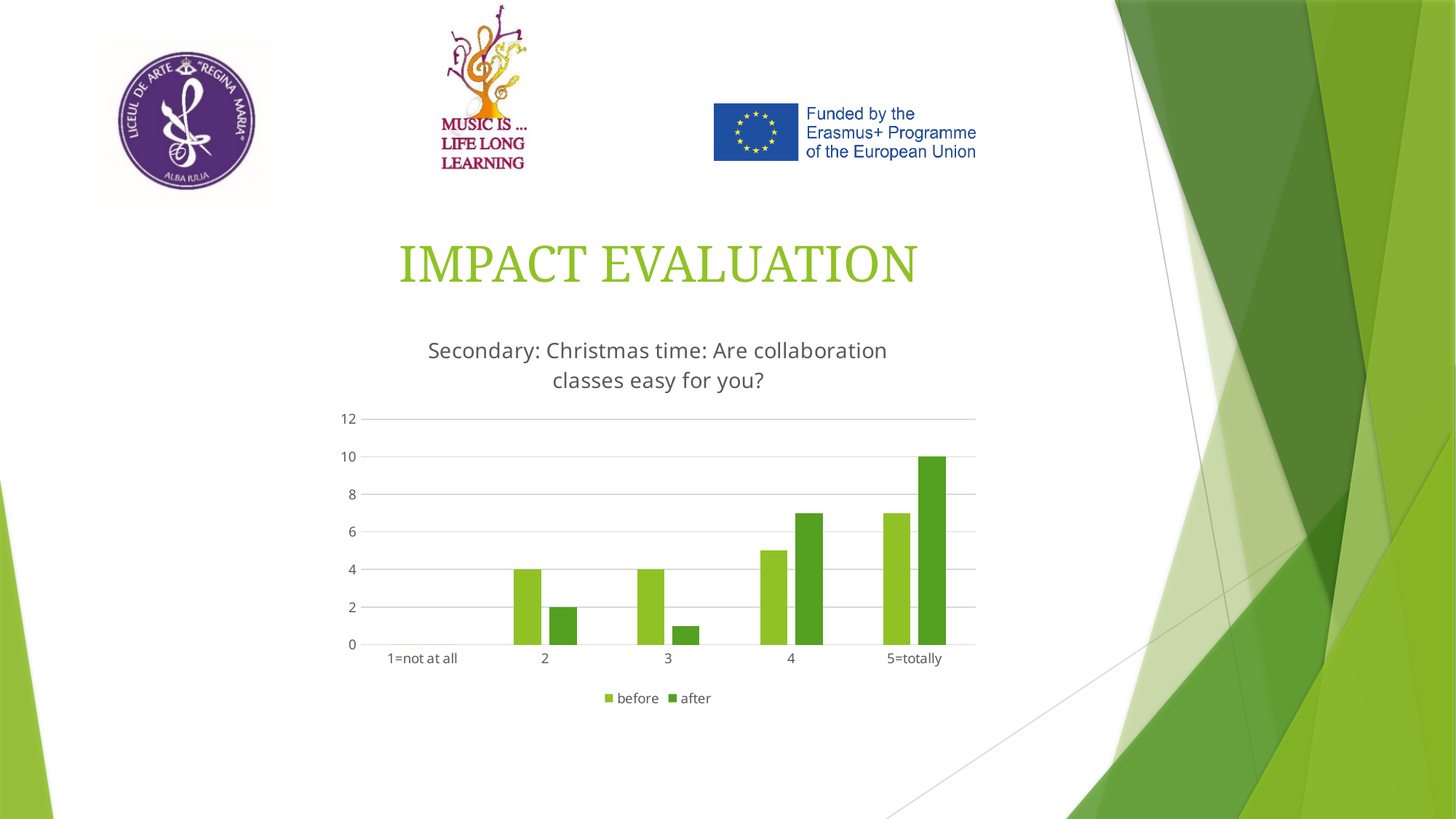
How many categories are shown on the x axis? 5 What is the value of the 'before' series for category 2? 4 What is the difference between the 'before' and 'after' values for category 2? 2 Which category has the highest value in the 'before' series? 5=totally What is the value of the 'after' series for category 2? 2 What kind of chart is shown on the slide? bar chart What is the value of the 'after' series for '5=totally'? 10 How many series does the legend list? 2 What is the title of the chart? Secondary: Christmas time: Are collaboration classes easy for you? For category 4, which is larger, the 'before' value or the 'after' value? after Which category has the highest value in the 'after' series? 5=totally Is the 'after' value for category 3 greater or less than 2? less